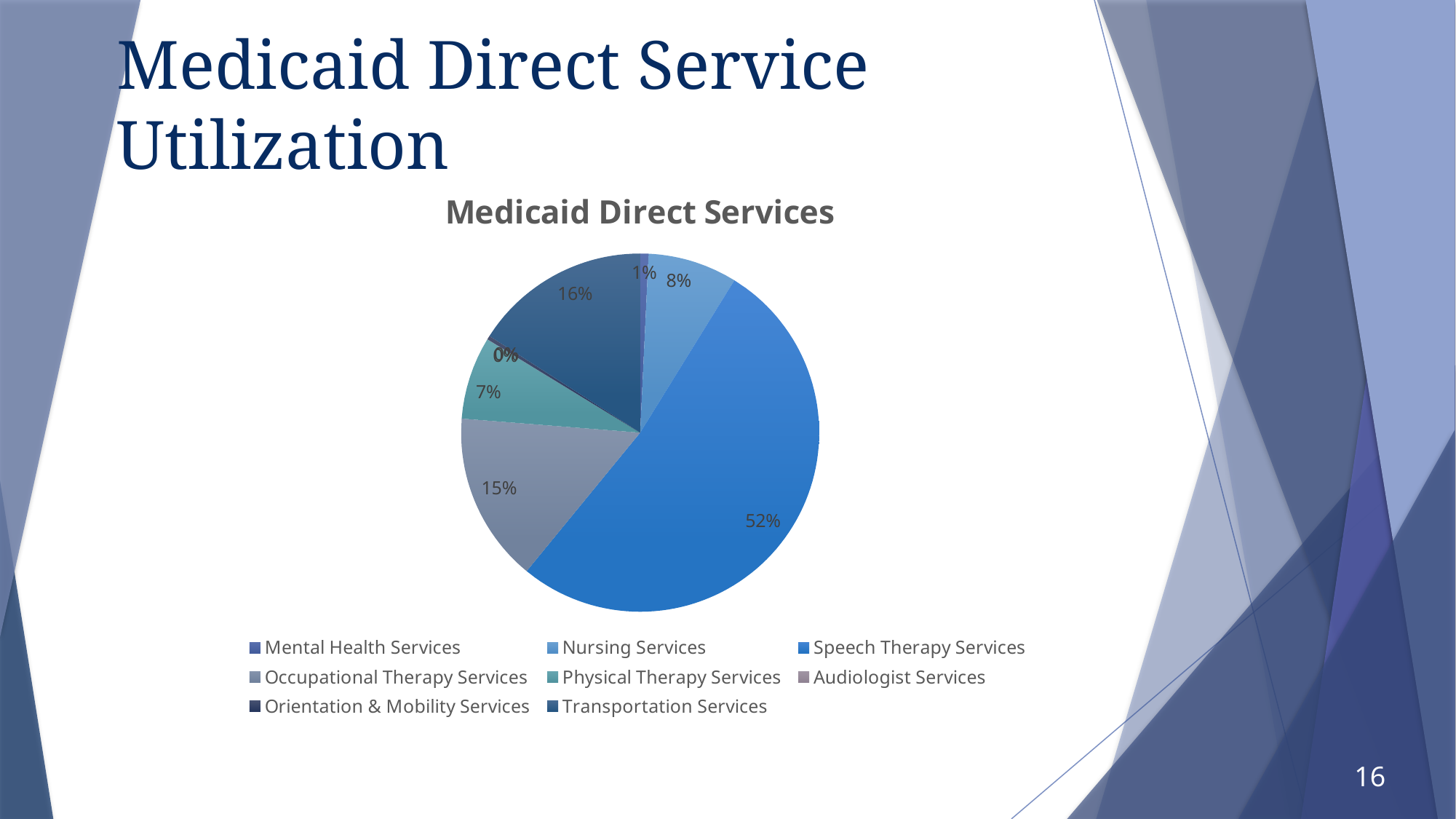
What share of the pie is Occupational Therapy Services? 15% How many entries does the chart legend list? 8 What is the difference between the share for Speech Therapy Services and the share for Transportation Services? 36% What share of the pie is Physical Therapy Services? 7% What share of the pie is Transportation Services? 16% Which service has the largest share of the pie? Speech Therapy Services What is the title of the chart? Medicaid Direct Services What kind of chart is shown on the slide? pie chart Which is larger, the share for Transportation Services or the share for Occupational Therapy Services? Transportation Services